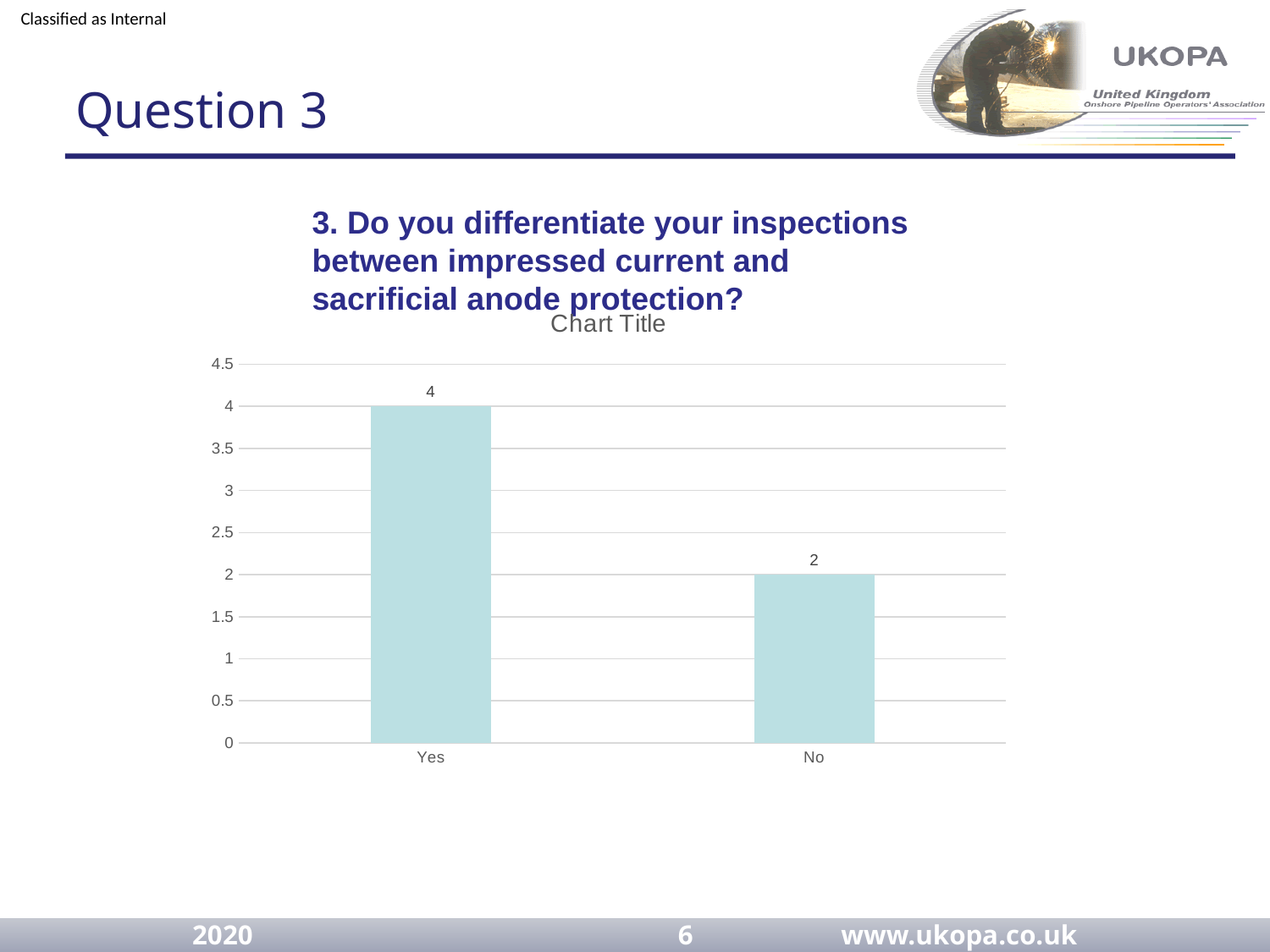
Which category has the lowest value? No What kind of chart is shown on the slide? bar chart How many categories are shown on the x axis? 2 What is the title printed directly above the chart? Chart Title Is the value for Yes greater or less than 3? greater Do the values rise or fall from Yes to No? fall Which category has the highest value? Yes Is the value for No greater or less than 3? less What is the value for No? 2 What is the value for Yes? 4 What is the difference between the values for Yes and No? 2 Which is larger, the value for Yes or the value for No? Yes